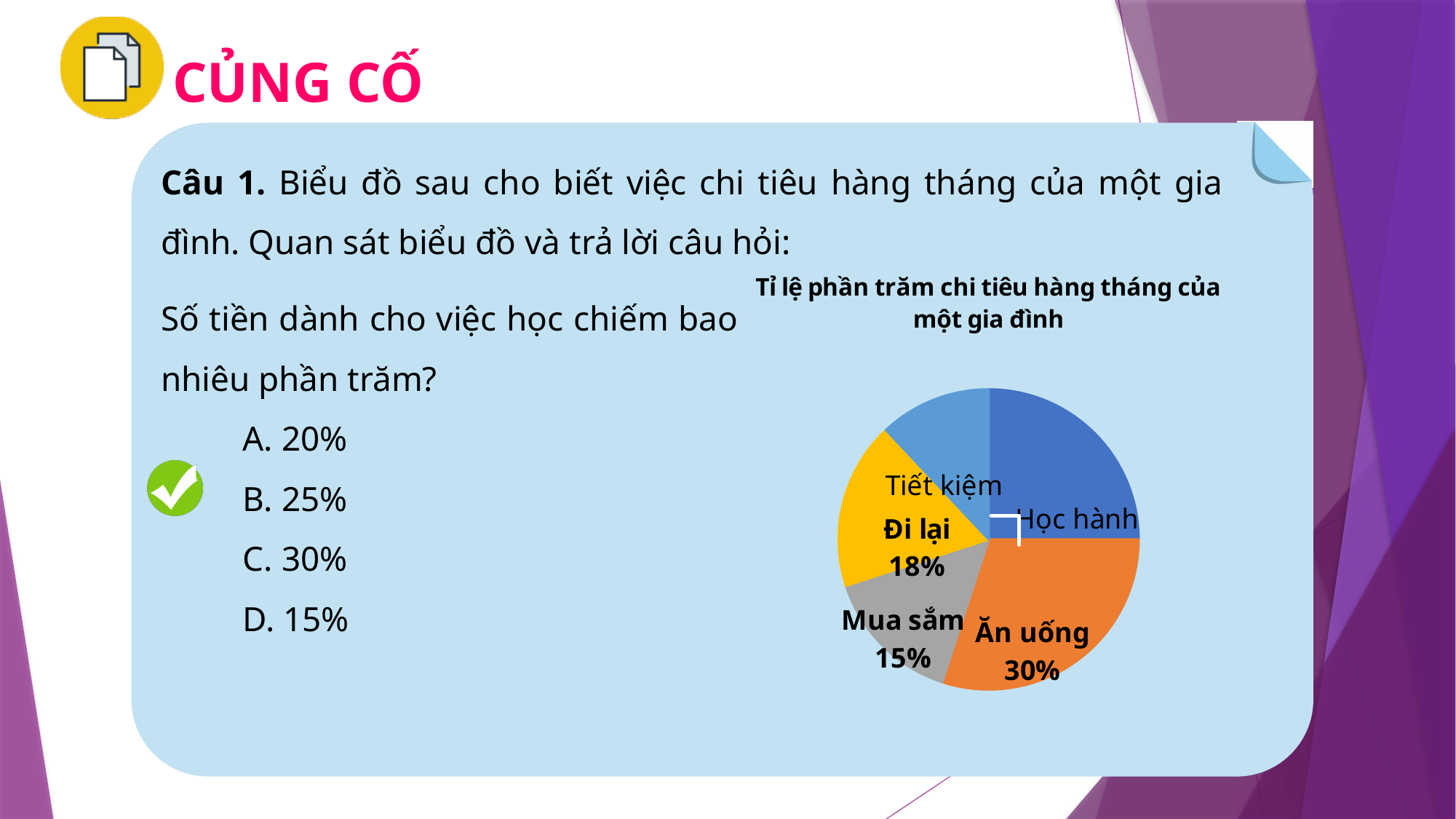
Which is larger, Đi lại or Mua sắm? Đi lại What is the difference between the Đi lại and Mua sắm percentages? 3% What is the title of the pie chart? Tỉ lệ phần trăm chi tiêu hàng tháng của một gia đình What percentage is shown for Mua sắm? 15% What kind of chart is shown on the slide? pie chart Which slice of the pie chart is the largest? Ăn uống Which is larger, Ăn uống or Đi lại? Ăn uống What colour is the Ăn uống slice? orange What percentage is shown for Đi lại? 18% What percentage is shown for Ăn uống? 30% How many slices does the pie chart have? 5 What is the difference between the Ăn uống and Mua sắm percentages? 15%